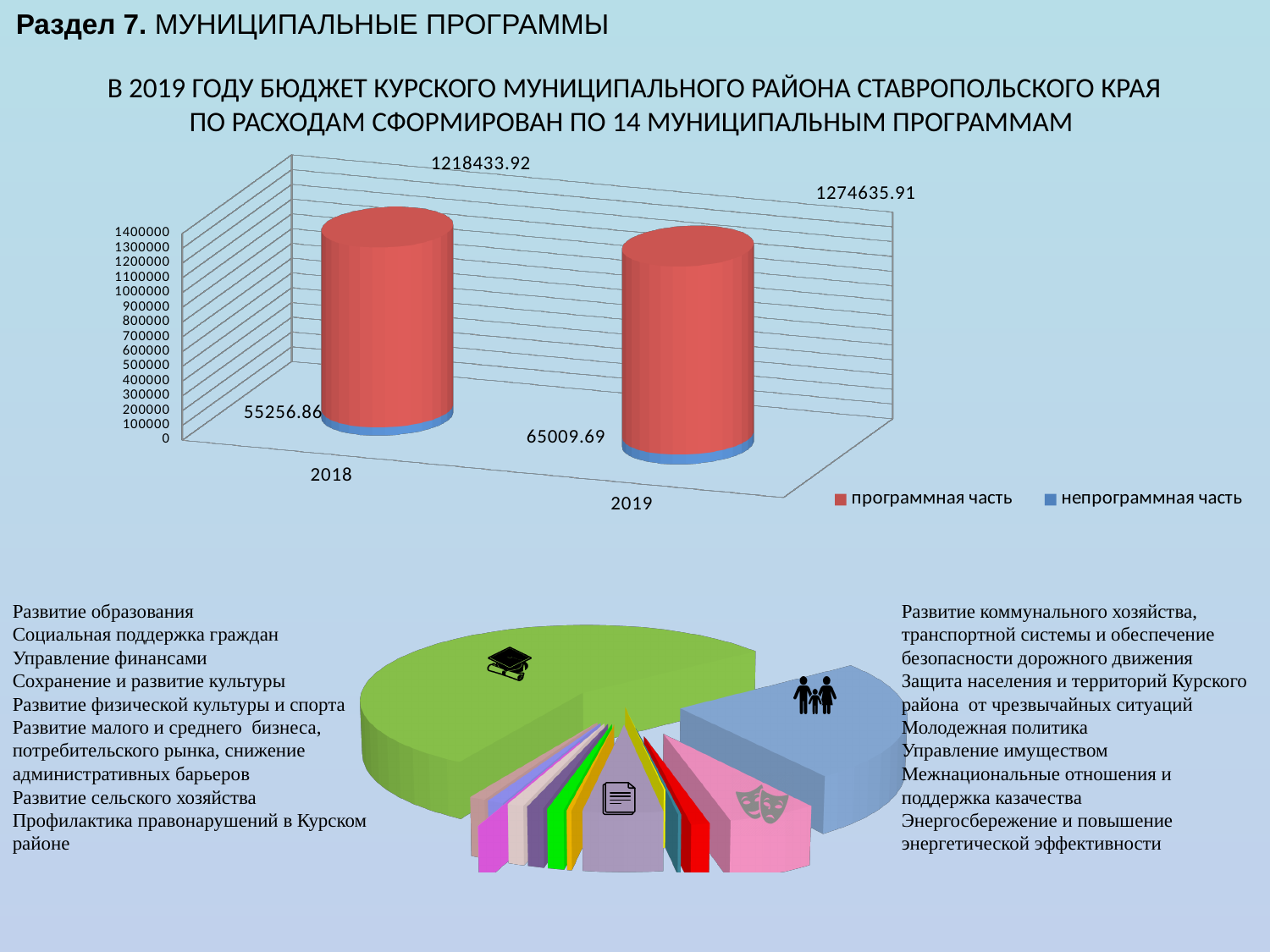
In the top chart, what is the value of программная часть for 2019? 1274635.91 What kind of chart is the chart at the bottom of the slide? Pie chart In the top chart, what is the value of непрограммная часть for 2018? 55256.86 In the top chart, which year has the higher value for программная часть? 2019 In the top chart, what is the value of программная часть for 2018? 1218433.92 In the top chart, what is the value of непрограммная часть for 2019? 65009.69 In the top chart, what is the difference between непрограммная часть in 2019 and in 2018? 9752.83 In the top chart, what is the total of the stacked bar for 2019? 1339645.60 How many series does the legend of the top chart list? 2 In the top chart, is the value of непрограммная часть for 2019 greater or less than 100000? less In the top chart, by how much does программная часть in 2019 exceed программная часть in 2018? 56201.99 How many years (categories) are shown on the x axis of the top chart? 2